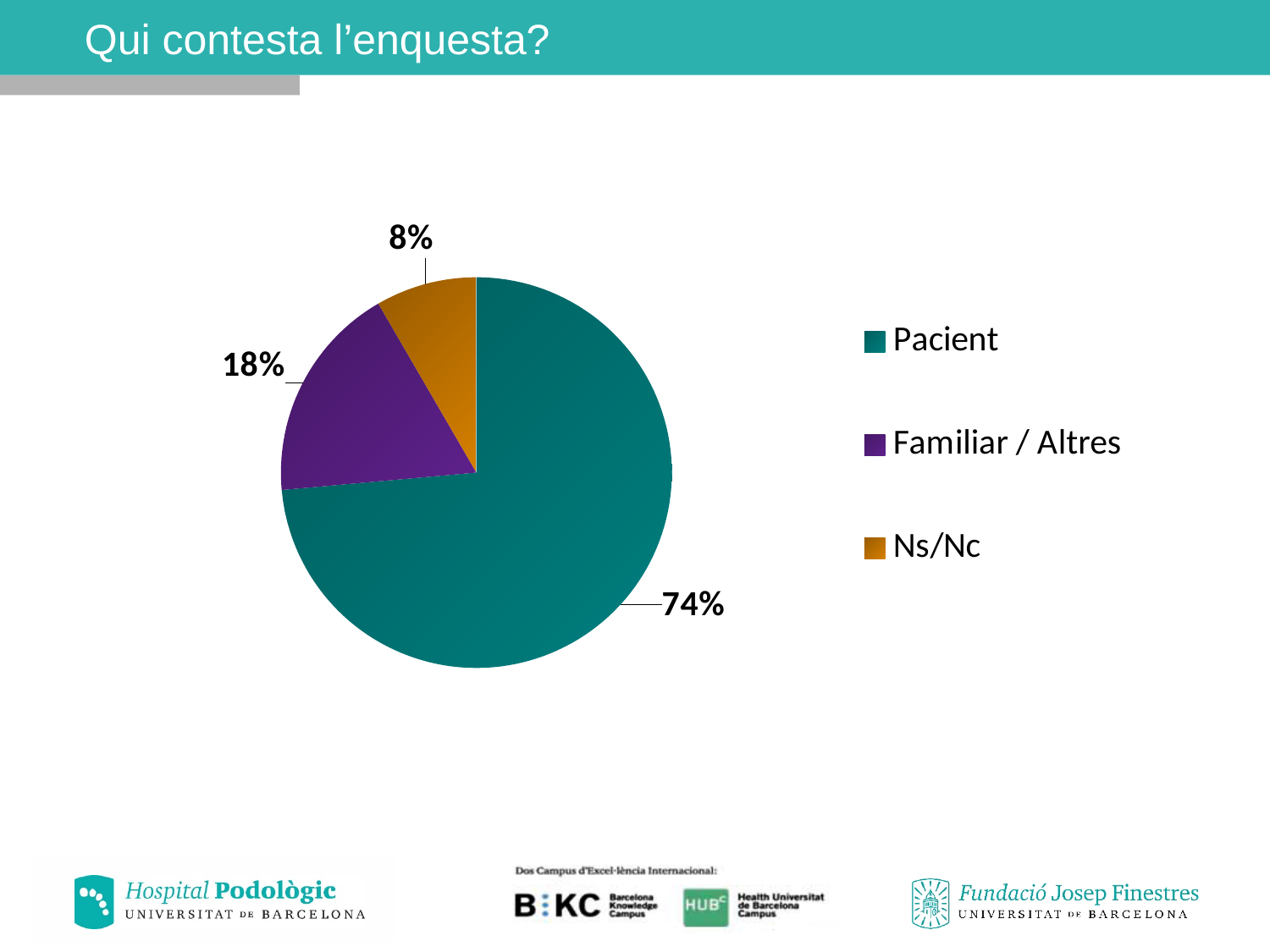
What percentage of the pie corresponds to Pacient? 74% Which is larger, the slice for Familiar / Altres or the slice for Ns/Nc? Familiar / Altres What is the difference in percentage points between Pacient and Familiar / Altres? 56 What percentage of the pie corresponds to Ns/Nc? 8% What colour is the slice for Ns/Nc? orange What kind of chart is shown on the slide? pie chart What percentage of the pie corresponds to Familiar / Altres? 18% What is the difference in percentage points between Familiar / Altres and Ns/Nc? 10 Which category has the smallest slice of the pie? Ns/Nc Which category has the largest slice of the pie? Pacient How many categories does the pie chart have? 3 What is the title of the slide containing the pie chart? Qui contesta l'enquesta?